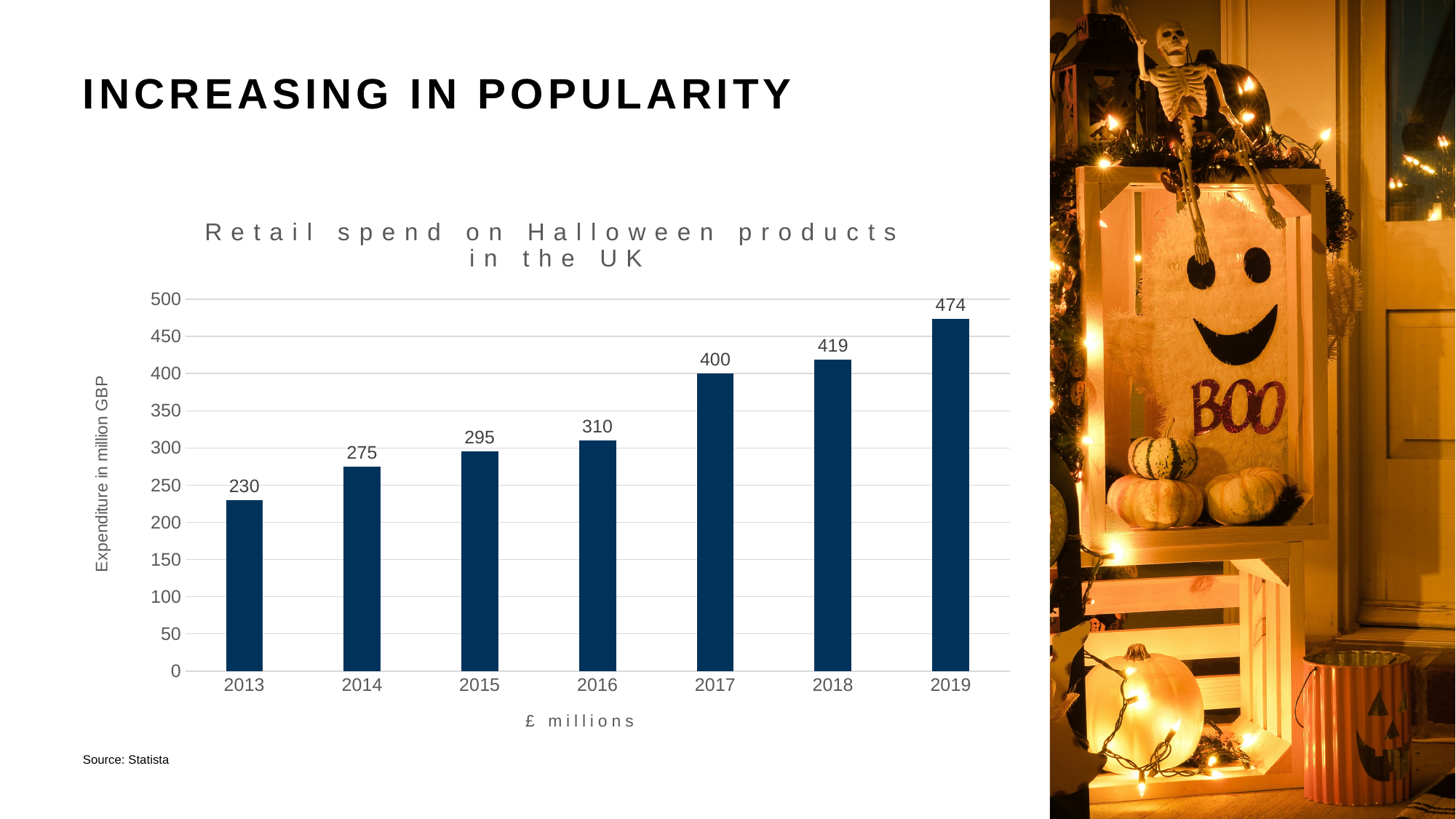
What value is shown for 2019? 474 Do the values rise or fall from 2013 to 2019? Rise What is the difference between the values for 2019 and 2018? 55 What kind of chart is shown on the slide? Bar chart How many years are shown on the x axis? 7 What is the difference between the values for 2016 and 2015? 15 Which is larger, the value for 2014 or the value for 2016? 2016 Which year has the highest retail spend? 2019 What was the retail spend on Halloween products in the UK in 2013? 230 What value is shown for 2017? 400 Is the value for 2018 greater or less than 400? greater Which year has the lowest retail spend? 2013